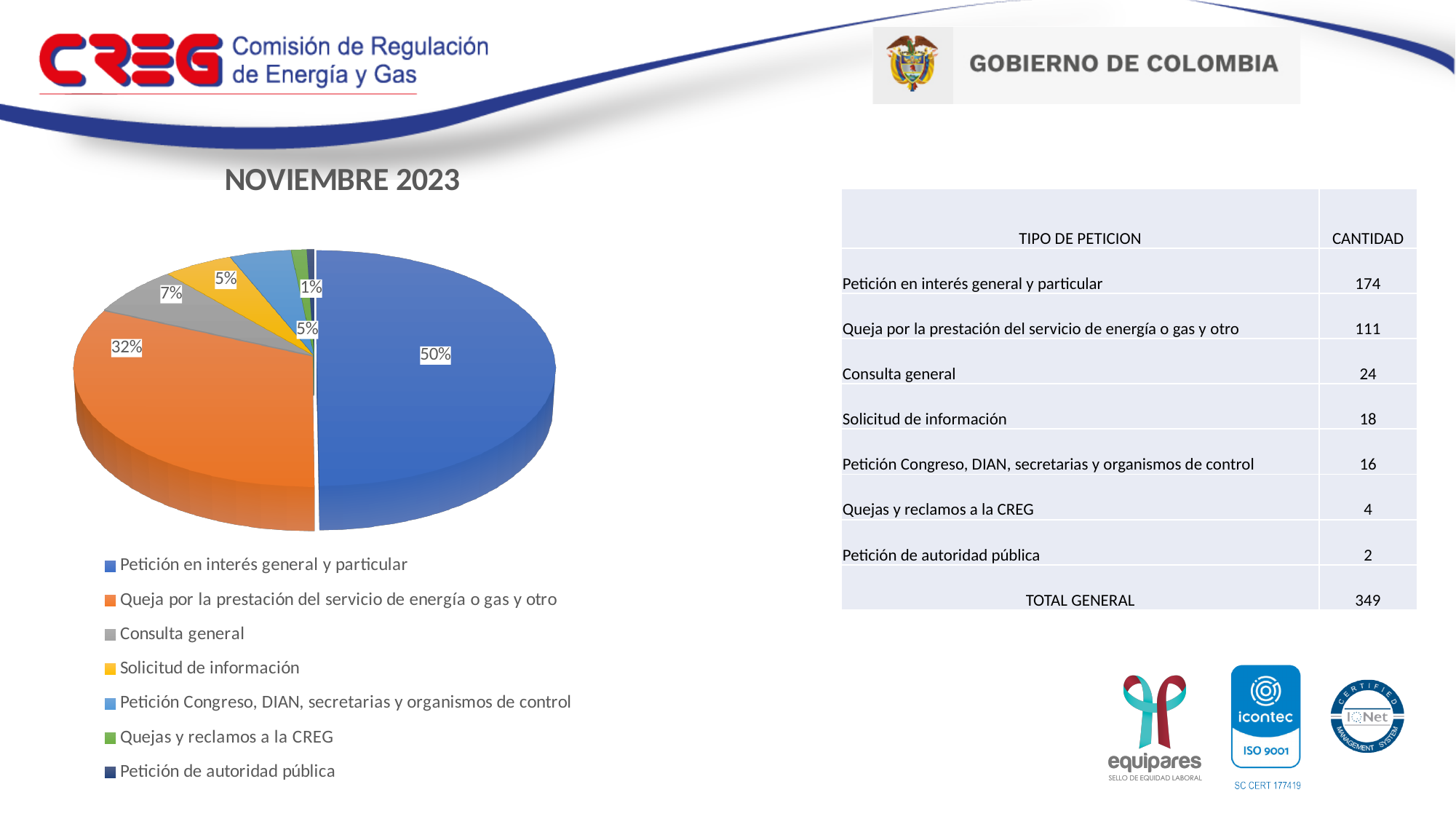
By how many percentage points does the 'Petición en interés general y particular' slice exceed the 'Queja por la prestación del servicio de energía o gas y otro' slice? 18 percentage points What percentage of the pie does 'Queja por la prestación del servicio de energía o gas y otro' represent? 32% What kind of chart is shown on the slide? pie chart What is the title of the pie chart? NOVIEMBRE 2023 What percentage of the pie does 'Solicitud de información' represent? 5% Which slice is larger: 'Queja por la prestación del servicio de energía o gas y otro' or 'Consulta general'? Queja por la prestación del servicio de energía o gas y otro Which category has the largest slice of the pie chart? Petición en interés general y particular How many categories does the pie chart's legend list? 7 What colour is the slice for 'Queja por la prestación del servicio de energía o gas y otro' in the pie chart? orange What percentage of the pie does 'Consulta general' represent? 7% What percentage of the pie does 'Petición en interés general y particular' represent? 50% What percentage of the pie does 'Petición Congreso, DIAN, secretarias y organismos de control' represent? 5%